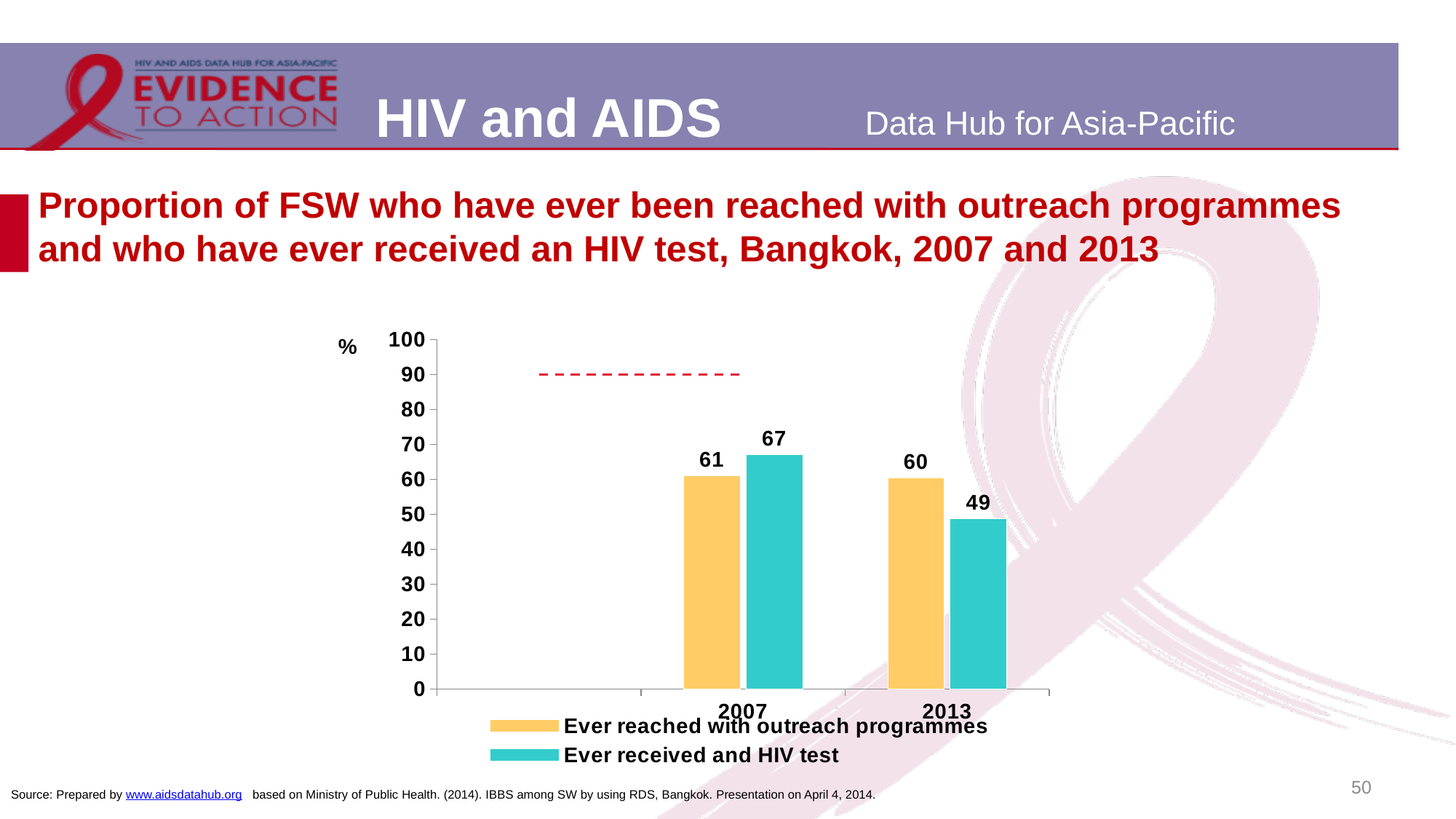
What is the value for 'Ever reached with outreach programmes' in 2013? 60 What is the value for 'Ever received and HIV test' in 2007? 67 Which year has the highest value for 'Ever received and HIV test'? 2007 What is the value for 'Ever reached with outreach programmes' in 2007? 61 What is the difference between the 'Ever received and HIV test' values in 2007 and 2013? 18 In 2013, which is larger: 'Ever reached with outreach programmes' or 'Ever received and HIV test'? Ever reached with outreach programmes What is the value for 'Ever received and HIV test' in 2013? 49 How many years are shown on the x axis? 2 What kind of chart is shown on the slide? bar chart Is the value for 'Ever received and HIV test' in 2013 greater or less than 50? less How many series does the legend list? 2 Does the value for 'Ever received and HIV test' rise or fall from 2007 to 2013? fall